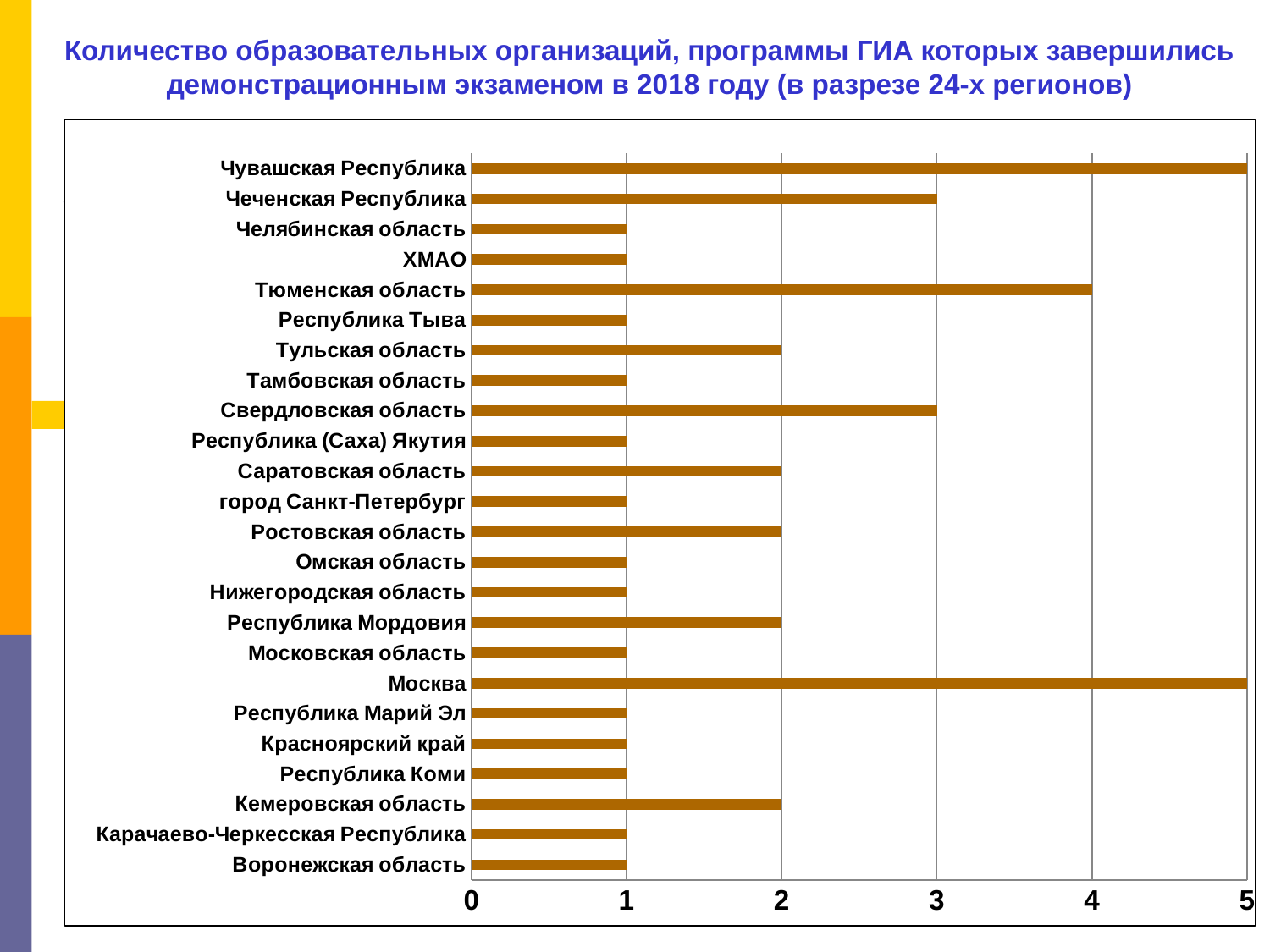
What is the difference between the values for Тюменская область and Свердловская область? 1 How many regions are listed on the chart? 24 Which has a larger value, Тульская область or Чеченская Республика? Чеченская Республика What is the value for Воронежская область? 1 What is the value for Москва? 5 Which regions have the highest value on the chart? Чувашская Республика and Москва What is the value for Кемеровская область? 2 What is the value for Тюменская область? 4 What kind of chart is shown on the slide? bar chart What is the value for Чеченская Республика? 3 What is the highest value shown on the horizontal axis? 5 What is the difference between the values for Чувашская Республика and Республика Мордовия? 3